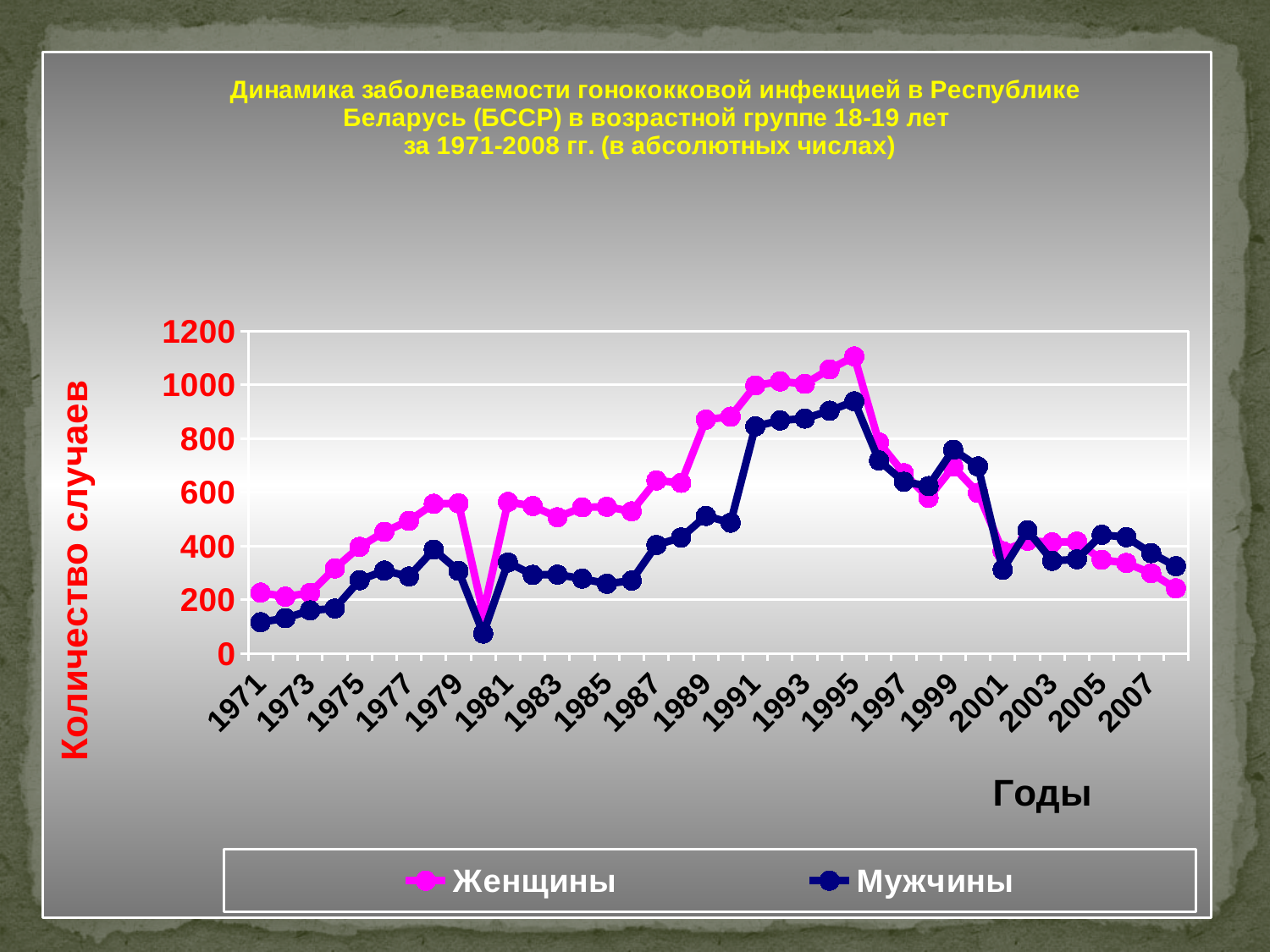
Is the value for Женщины in 1995 greater or less than 1000? greater In which year does the Мужчины series reach its lowest value? 1980 What are the two series named in the legend? Женщины and Мужчины Is the value for Женщины in 1980 greater or less than 200? less What is the title of the vertical axis? Количество случаев What kind of chart is shown on the slide? line chart Is the value for Мужчины in 1971 greater or less than 200? less In which year does the Мужчины series reach its highest value? 1995 How many series does the legend list? 2 In which year does the Женщины series reach its highest value? 1995 In 2008, which series has the higher value, Женщины or Мужчины? Мужчины In 1991, which series has the higher value, Женщины or Мужчины? Женщины